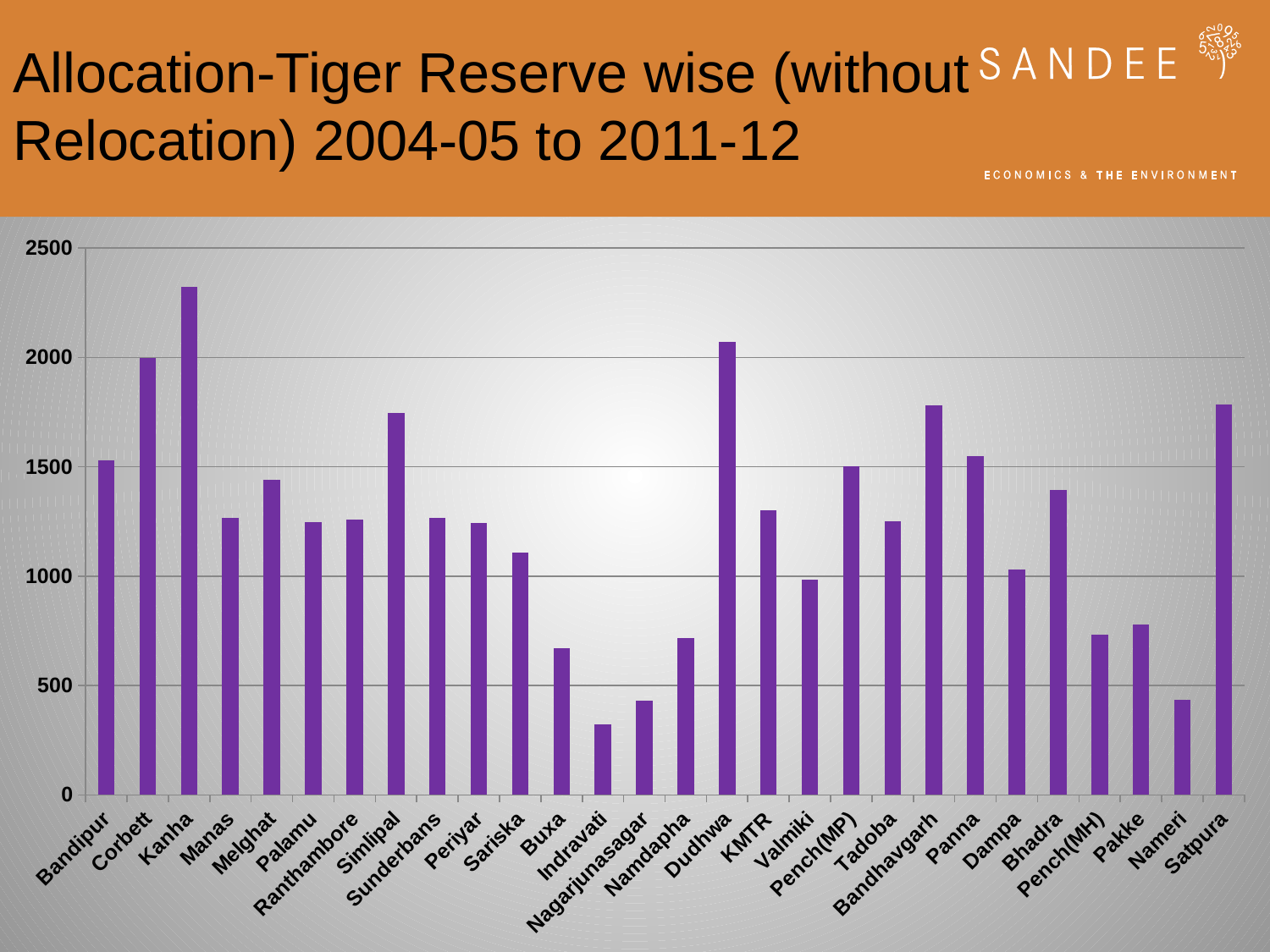
Which has a larger allocation, Buxa or Satpura? Satpura How many tiger reserves are shown on the x axis of the chart? 28 Which tiger reserve has the lowest allocation in the chart? Indravati What kind of chart is shown on the slide? bar chart Is the value for Indravati greater or less than 500? less Which has a larger allocation, Simlipal or Sunderbans? Simlipal What is the title of the chart on the slide? Allocation-Tiger Reserve wise (without Relocation) 2004-05 to 2011-12 Which tiger reserve has the highest allocation in the chart? Kanha Is the value for Kanha greater or less than 2000? greater Is the value for Nameri greater or less than 500? less